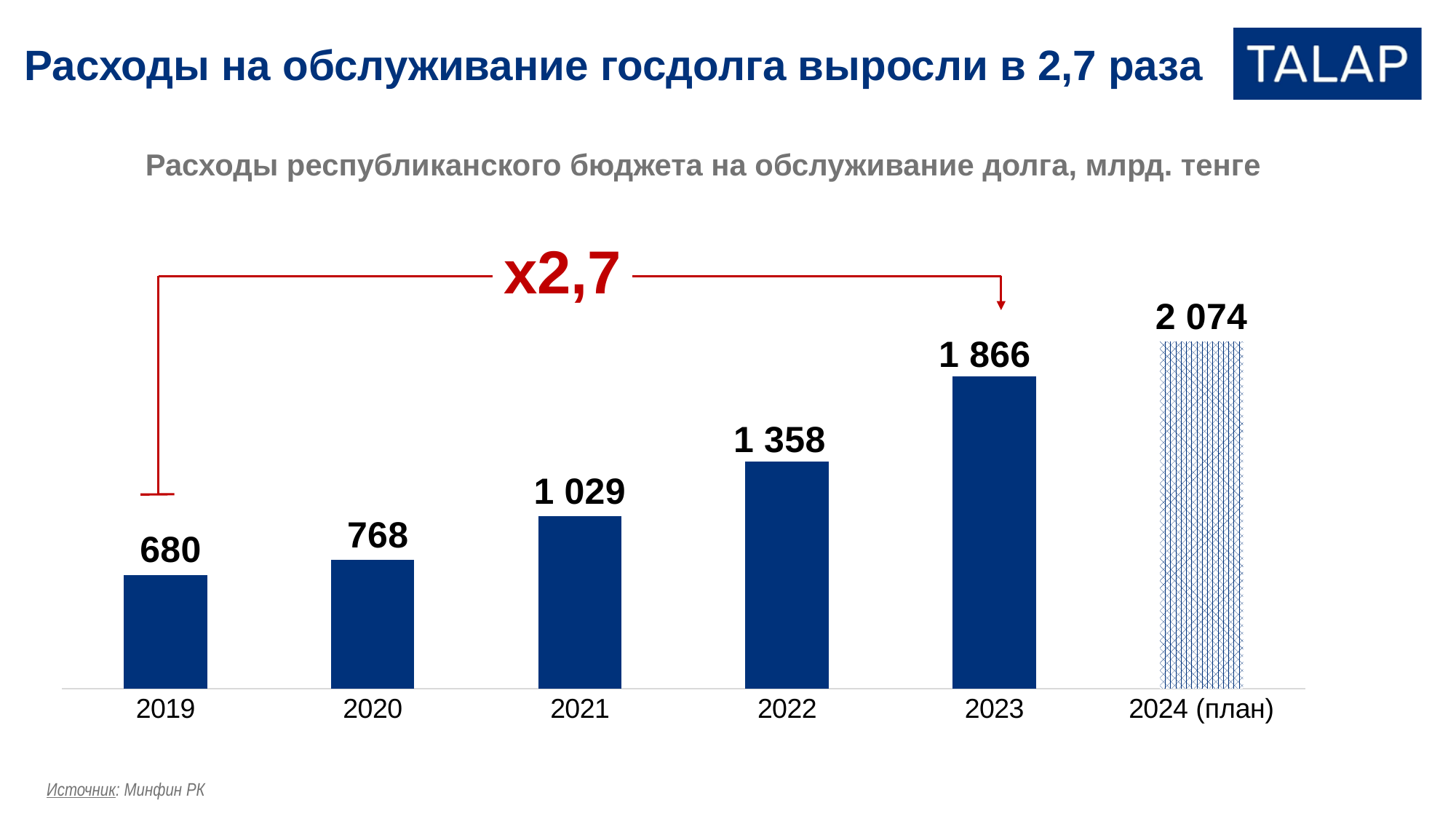
What kind of chart is this? bar chart What is the value for 2021? 1 029 How many years are shown on the x axis? 6 What is the planned value for 2024 (план)? 2 074 What is the difference between the values for 2023 and 2019? 1 186 Which year has the lowest value? 2019 Which is larger, the value for 2020 or the value for 2022? 2022 What is the difference between the values for 2022 and 2021? 329 What is the value for 2023? 1 866 What is the value for 2019? 680 Do the values rise or fall from 2019 to 2024 (план)? rise Which year has the highest value? 2024 (план)